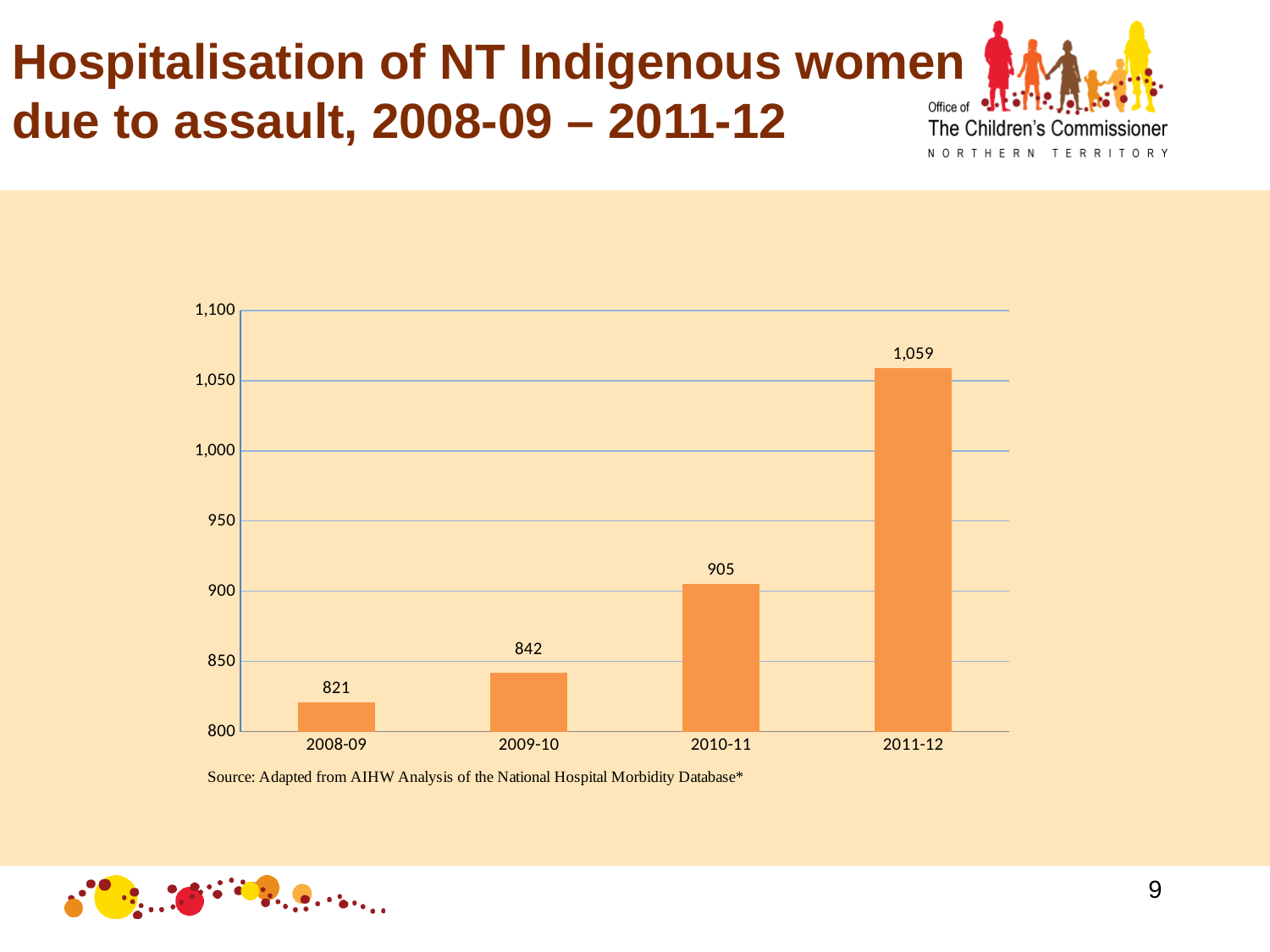
What is the value for 2009-10? 842 Is the value for 2011-12 greater or less than 1,000? greater Which year has the highest value? 2011-12 What is the value for 2011-12? 1,059 Which is larger, the value for 2010-11 or the value for 2009-10? 2010-11 What is the difference between the values for 2011-12 and 2010-11? 154 What is the value for 2008-09? 821 What kind of chart is shown on the slide? bar chart What is the value for 2010-11? 905 What is the difference between the values for 2009-10 and 2008-09? 21 Which year has the lowest value? 2008-09 How many years are shown on the x axis? 4